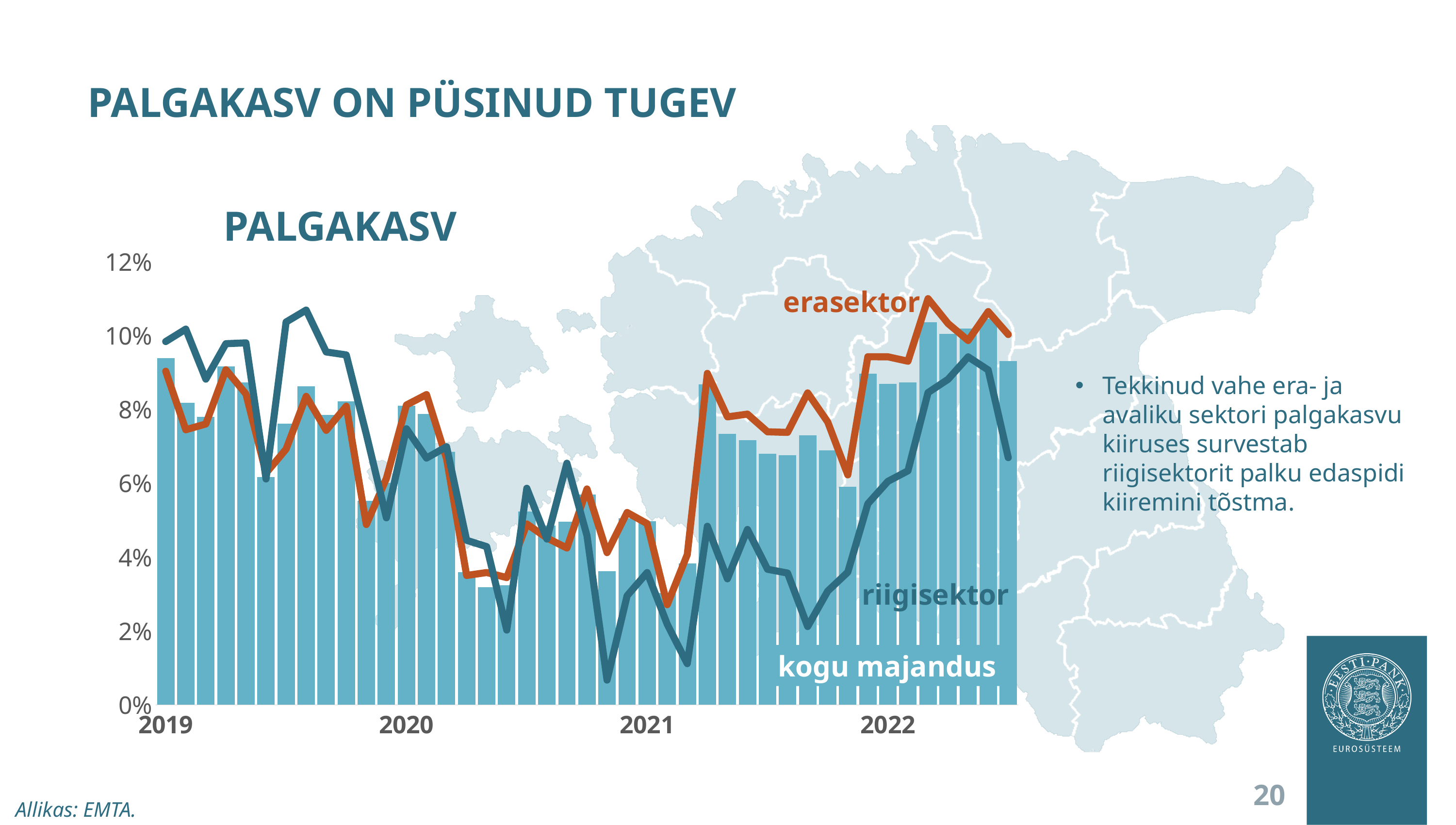
At the end of the series in 2022, which is higher, erasektor or riigisektor? erasektor Is the value for riigisektor at the start of 2021 greater or less than 2%? greater At the start of 2021, which is higher, erasektor or riigisektor? erasektor Does the erasektor line generally rise or fall from the start of 2021 to the start of 2022? rise Is the value for erasektor at the start of 2021 greater or less than 4%? greater Is the value for erasektor at the start of 2019 greater or less than 8%? greater What kind of chart is shown on the slide? A combined bar and line chart How many data series are shown in the chart? 3 Which series is drawn as bars in the chart? kogu majandus What is the title of the chart? PALGAKASV